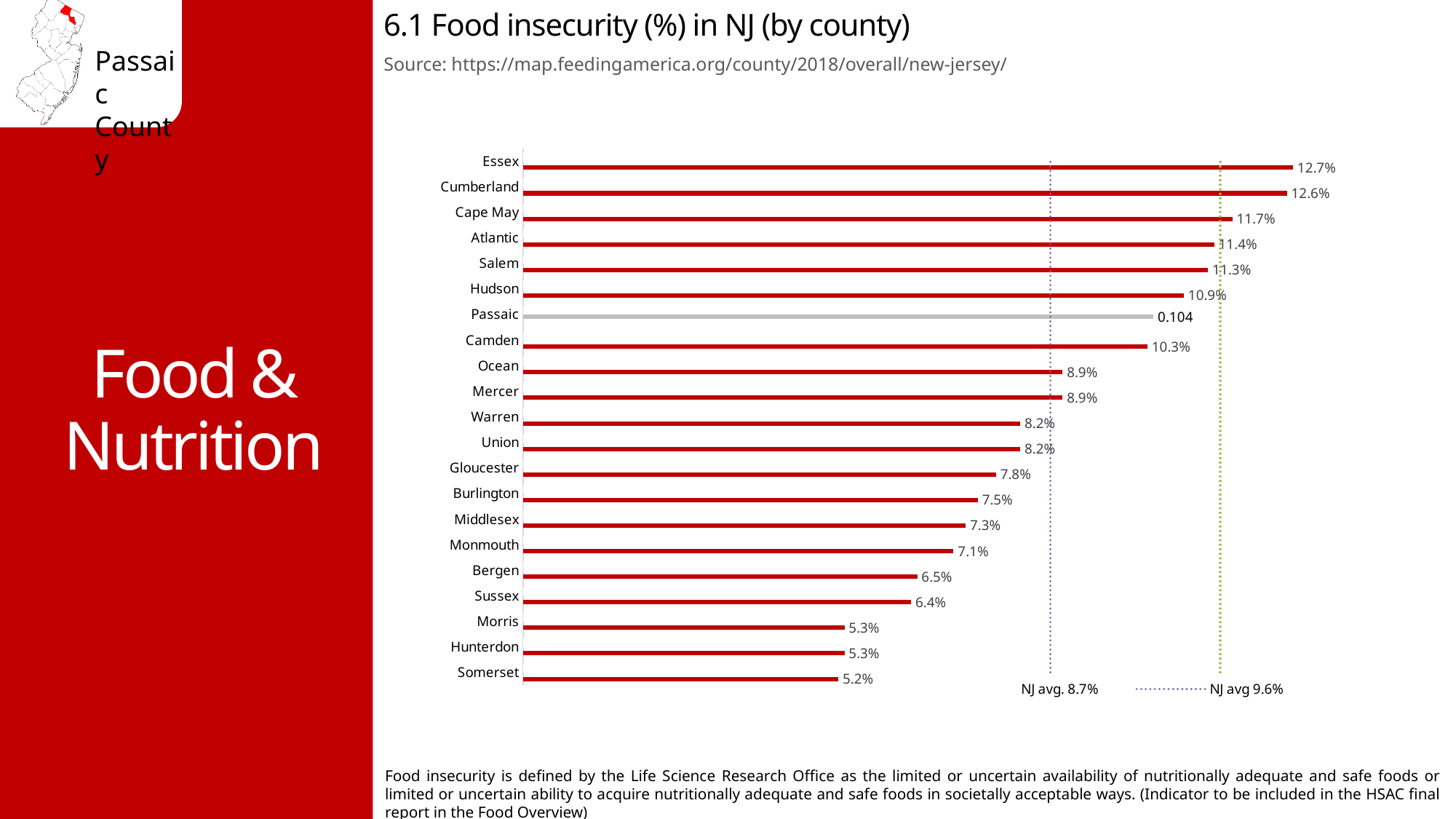
How many counties are plotted in the chart? 21 What is the difference in percentage points between Essex and Somerset? 7.5 Which county has the highest food insecurity percentage? Essex What is the food insecurity value for Hudson county? 10.9% What is the food insecurity value shown for Essex county? 12.7% What value is printed next to the Passaic bar? 0.104 Which county has the lowest food insecurity percentage? Somerset What is the difference in percentage points between Hudson and Camden? 0.6 Which has a higher food insecurity value, Cape May or Salem? Cape May Which has a higher food insecurity value, Bergen or Monmouth? Monmouth What kind of chart is shown on the slide? Bar chart What value is labelled on the dotted line marked 'NJ avg 9.6%'? 9.6%